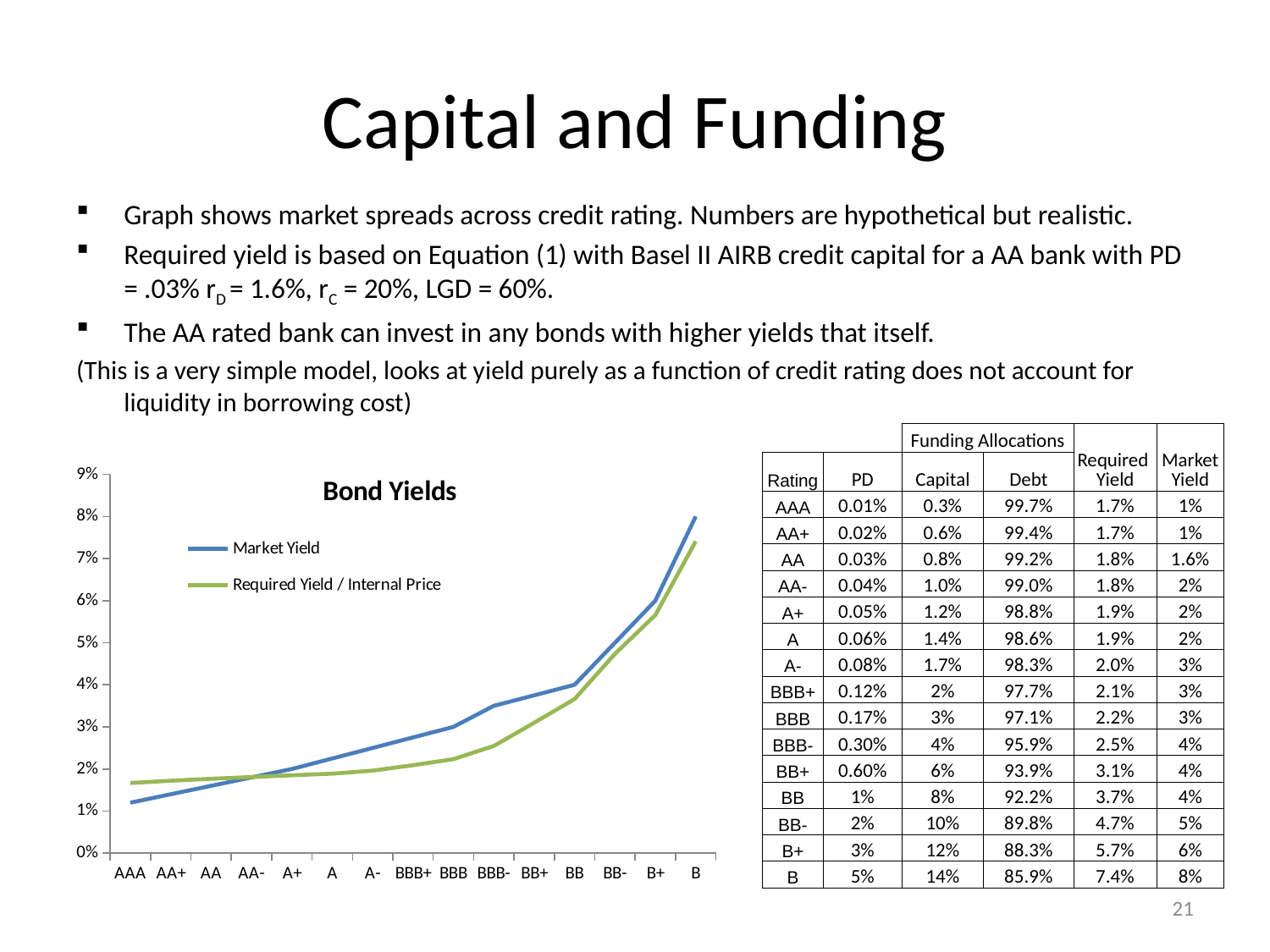
How many credit rating categories are shown on the x axis of the chart? 15 At rating B, which series has the higher value, Market Yield or Required Yield / Internal Price? Market Yield Is the Required Yield / Internal Price value for BB greater or less than 4%? less What kind of chart is shown on the slide? line chart At which rating does the Required Yield / Internal Price series reach its highest value? B At rating AAA, which series has the higher value, Market Yield or Required Yield / Internal Price? Required Yield / Internal Price Do the Market Yield values rise or fall moving along the x axis from AAA to B? rise Which series is drawn in blue in the chart? Market Yield At which rating does the Market Yield series reach its highest value? B How many series does the chart legend list? 2 What is the title of the chart? Bond Yields Is the Required Yield / Internal Price value for B greater or less than 7%? greater